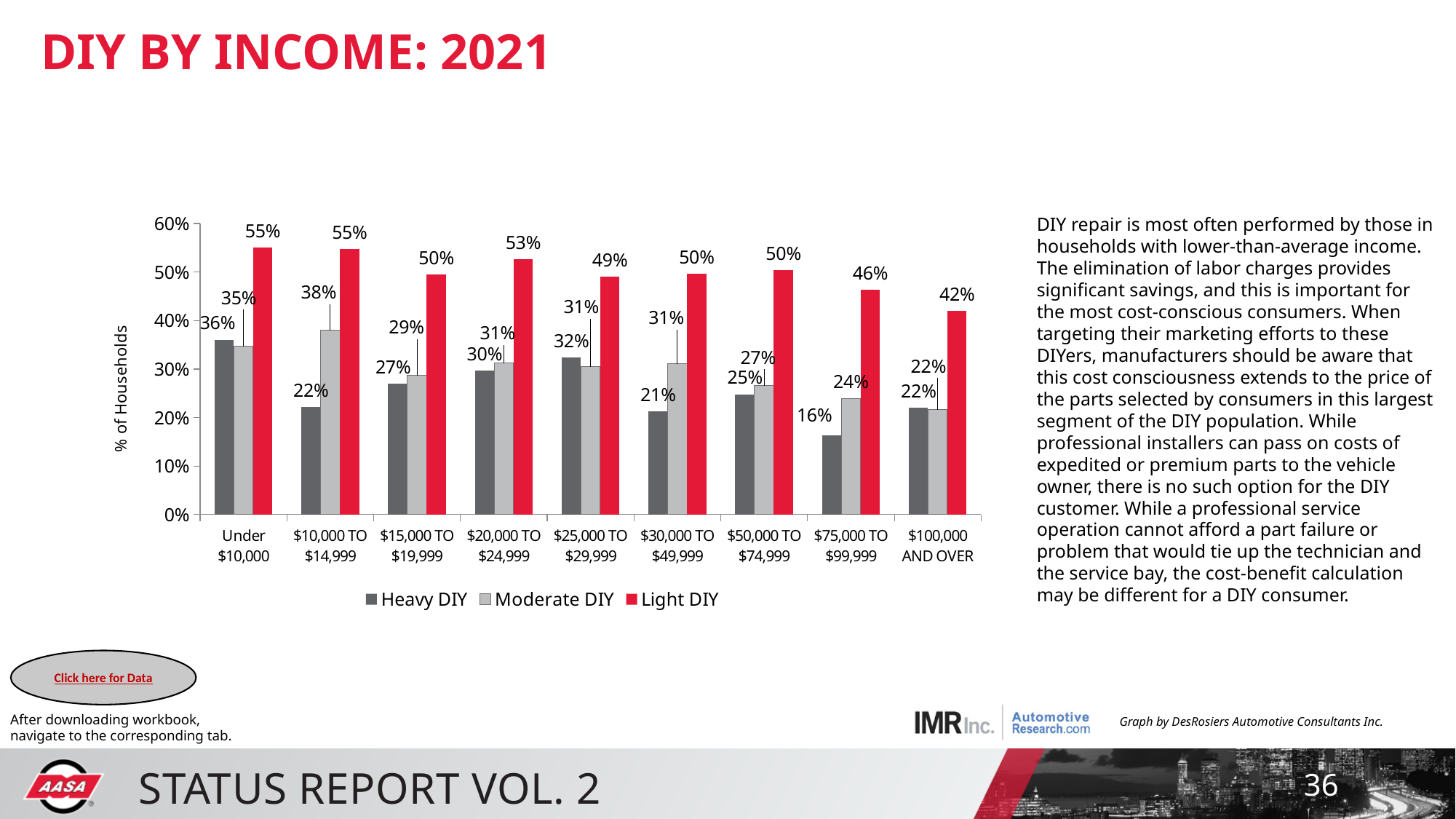
What is the difference between the Light DIY and Heavy DIY values for the $75,000 to $99,999 income group? 30 percentage points Which income group has the lowest Light DIY value? $100,000 and over What is the Light DIY value for households with income of $100,000 and over? 42% For the $10,000 to $14,999 income group, which is larger: Heavy DIY or Moderate DIY? Moderate DIY How many income groups are shown on the x axis? 9 Which income group has the highest Heavy DIY value? Under $10,000 What is the Moderate DIY value for the $10,000 to $14,999 income group? 38% What is the Heavy DIY value for the $30,000 to $49,999 income group? 21% Which income group has the lowest Heavy DIY value? $75,000 to $99,999 What kind of chart is shown on the slide? Bar chart How many series does the legend list? 3 What colour represents the Light DIY series? Red